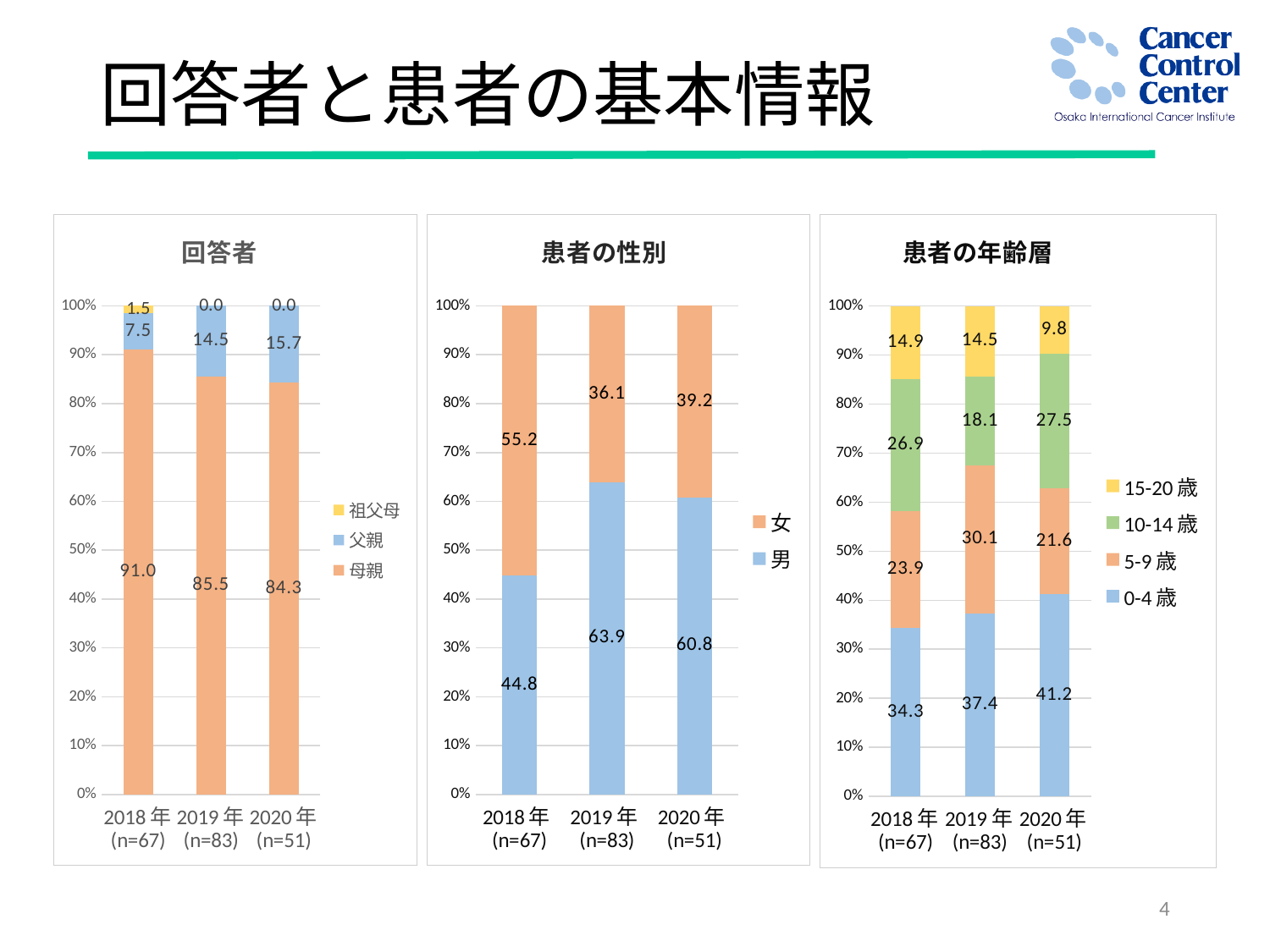
In the 患者の年齢層 chart, how many categories are shown on the x axis? 3 In the 患者の性別 chart, what is the value for 男 in 2019年 (n=83)? 63.9 In the 回答者 chart, which year has the highest value for 母親? 2018年 (n=67) In the 患者の性別 chart, what is the difference between 女 in 2018年 (n=67) and 女 in 2019年 (n=83)? 19.1 In the 患者の性別 chart, does the value for 男 rise or fall from 2018年 to 2019年? rise In the 回答者 chart, how many series does the legend list? 3 In the 患者の年齢層 chart, what is the value for 10-14歳 in 2019年 (n=83)? 18.1 In the 回答者 chart, what is the value for 父親 in 2020年 (n=51)? 15.7 In the 回答者 chart, what is the value for 母親 in 2018年 (n=67)? 91.0 In the 患者の年齢層 chart, which year has the lowest value for 15-20歳? 2020年 (n=51) What kind of chart is the 患者の年齢層 chart? stacked bar chart In the 患者の性別 chart, which is larger in 2020年 (n=51), 男 or 女? 男